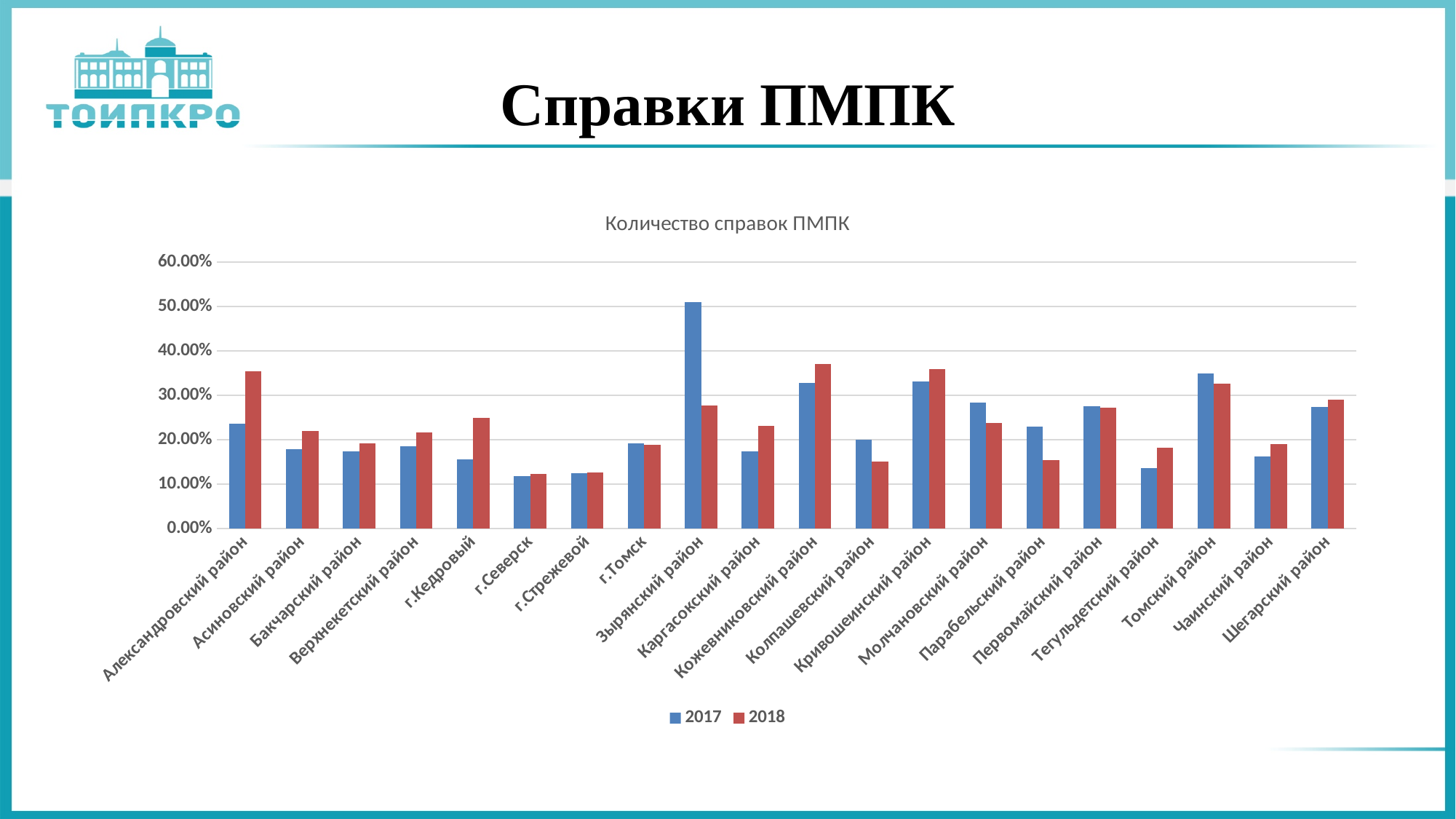
Which district has the highest value for 2017? Зырянский район Is the 2018 value for Колпашевский район greater or less than 20.00%? less For г.Кедровый, which year has the larger value, 2017 or 2018? 2018 How many districts (categories) are shown on the x axis? 20 Is the 2017 value for Зырянский район greater or less than 40.00%? greater How many series does the legend list? 2 What kind of chart is shown on the slide? bar chart For Зырянский район, which year has the larger value, 2017 or 2018? 2017 What is the title of the chart? Количество справок ПМПК For Парабельский район, which year has the larger value, 2017 or 2018? 2017 Is the 2018 value for Александровский район greater or less than 30.00%? greater